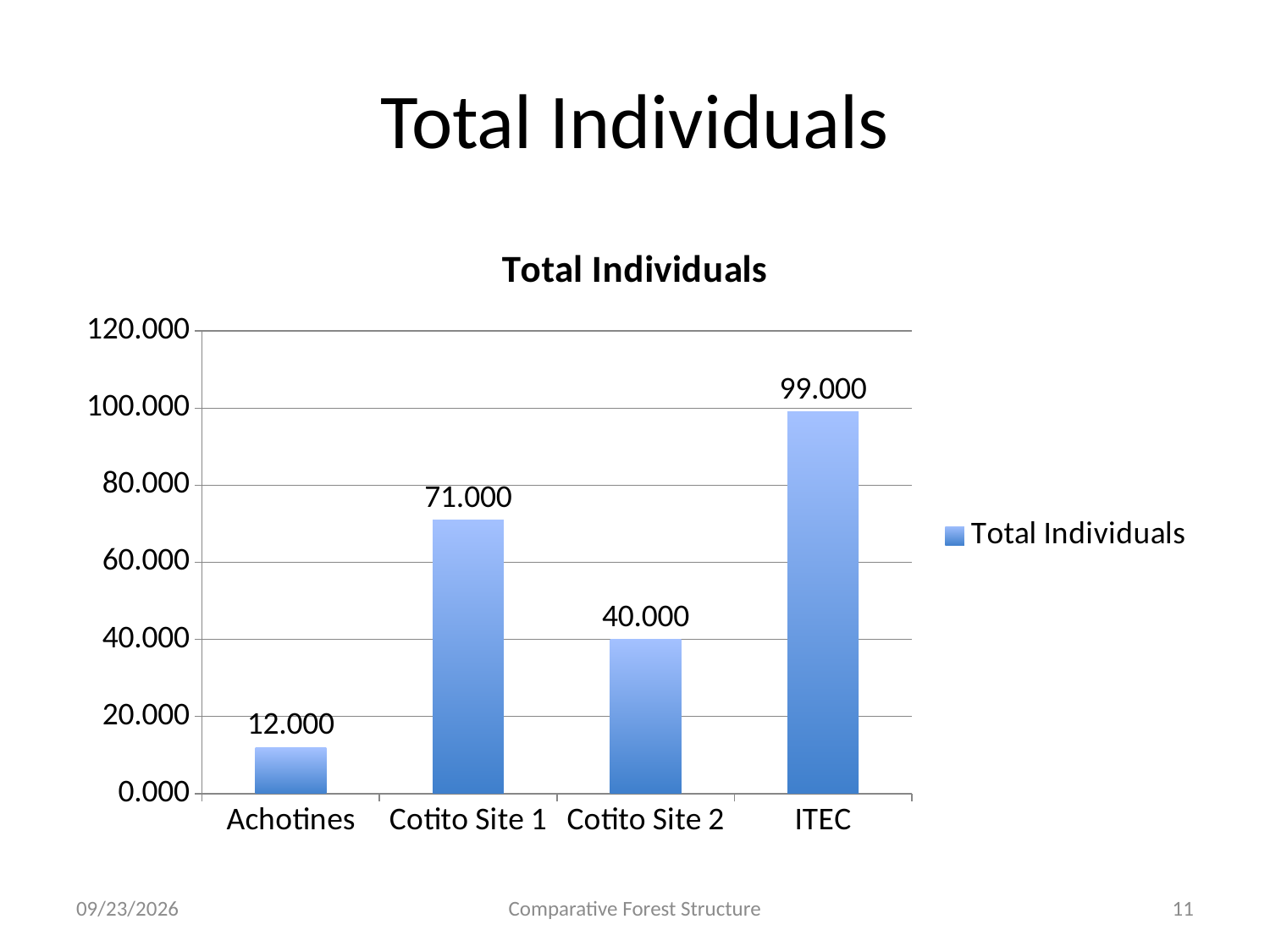
Is the value for Cotito Site 1 greater or less than 60.000? greater What is the value for ITEC? 99.000 Which is larger, the value for Cotito Site 1 or Cotito Site 2? Cotito Site 1 Which category has the highest value? ITEC How many series does the legend list? 1 Which category has the lowest value? Achotines What kind of chart is shown? bar chart How many categories are shown on the x axis? 4 What is the difference between the values for Cotito Site 1 and Cotito Site 2? 31.000 What is the difference between the values for ITEC and Achotines? 87.000 What is the value for Achotines? 12.000 What is the value for Cotito Site 2? 40.000